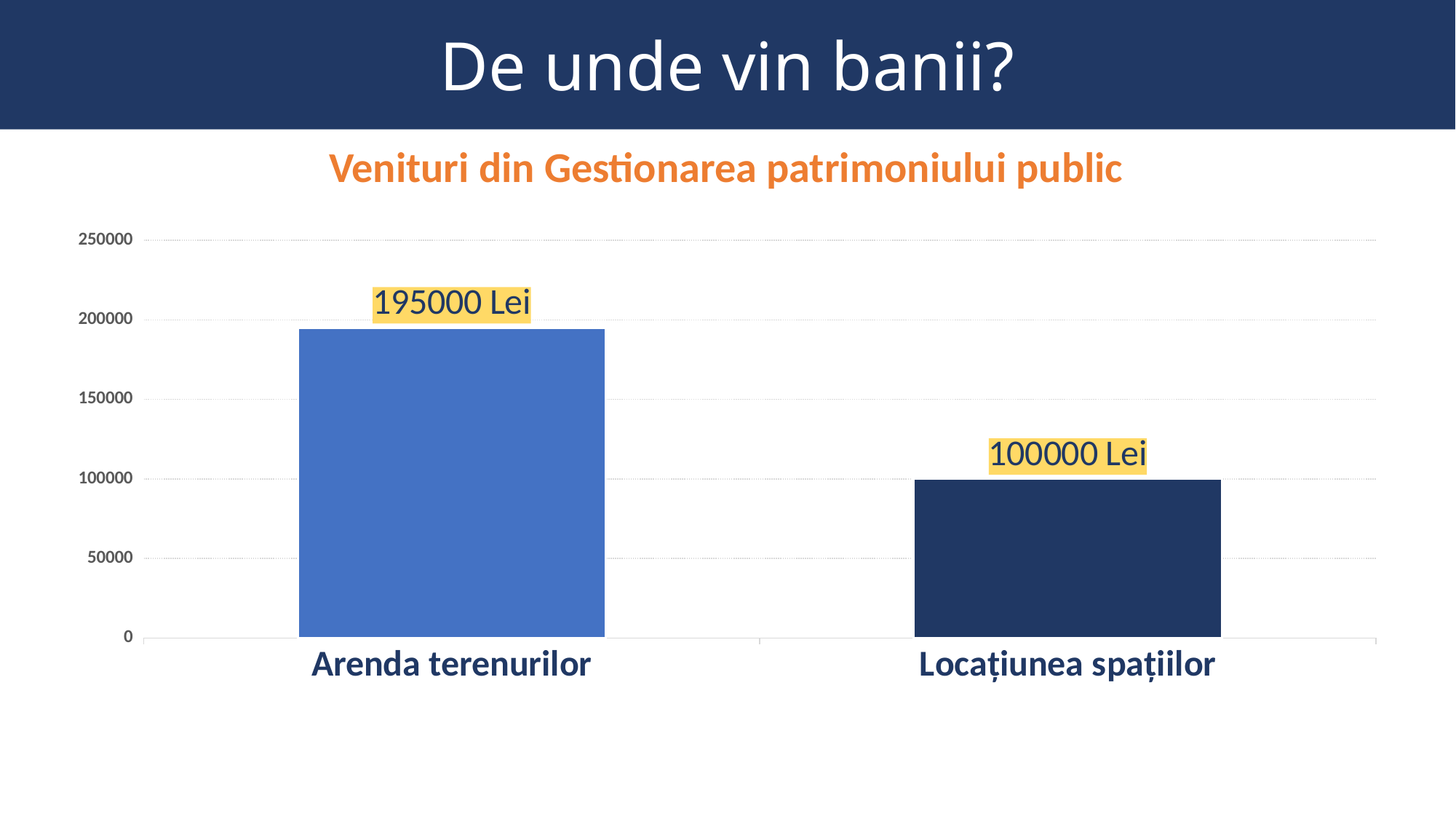
Is the value for Locațiunea spațiilor greater or less than 150000? less How many categories are shown in the chart? 2 Which is larger, the value for Arenda terenurilor or the value for Locațiunea spațiilor? Arenda terenurilor What is the title of the chart? Venituri din Gestionarea patrimoniului public What kind of chart is shown on the slide? bar chart What is the difference between the values for Arenda terenurilor and Locațiunea spațiilor? 95000 Lei What is the value for Locațiunea spațiilor? 100000 Lei What is the value for Arenda terenurilor? 195000 Lei Which category has the highest value? Arenda terenurilor Which category has the lowest value? Locațiunea spațiilor Is the value for Arenda terenurilor greater or less than 150000? greater What colour is the bar for Arenda terenurilor? blue